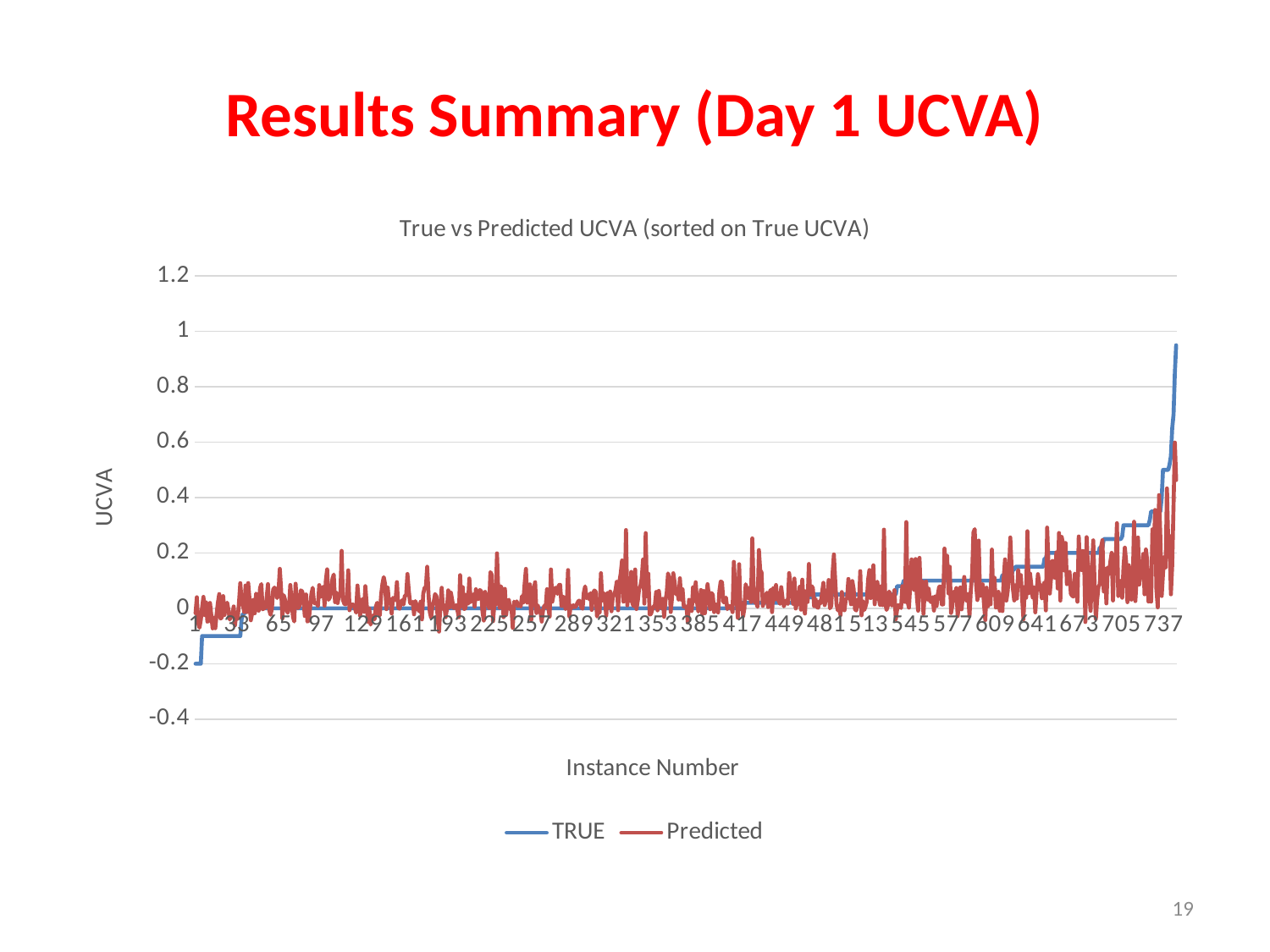
Is the highest Predicted value on the chart greater or less than 0.8? less Which series reaches the lower minimum value, TRUE or Predicted? TRUE What kind of chart is shown on the slide? Line chart How many series does the legend list? 2 What is the label of the x axis? Instance Number Is the TRUE value at instance 385 greater or less than 0.2? less Does the TRUE series rise or fall as the instance number increases? Rises Which series reaches the higher maximum value, TRUE or Predicted? TRUE Is the highest TRUE value on the chart greater or less than 0.8? greater What is the title of the chart? True vs Predicted UCVA (sorted on True UCVA)